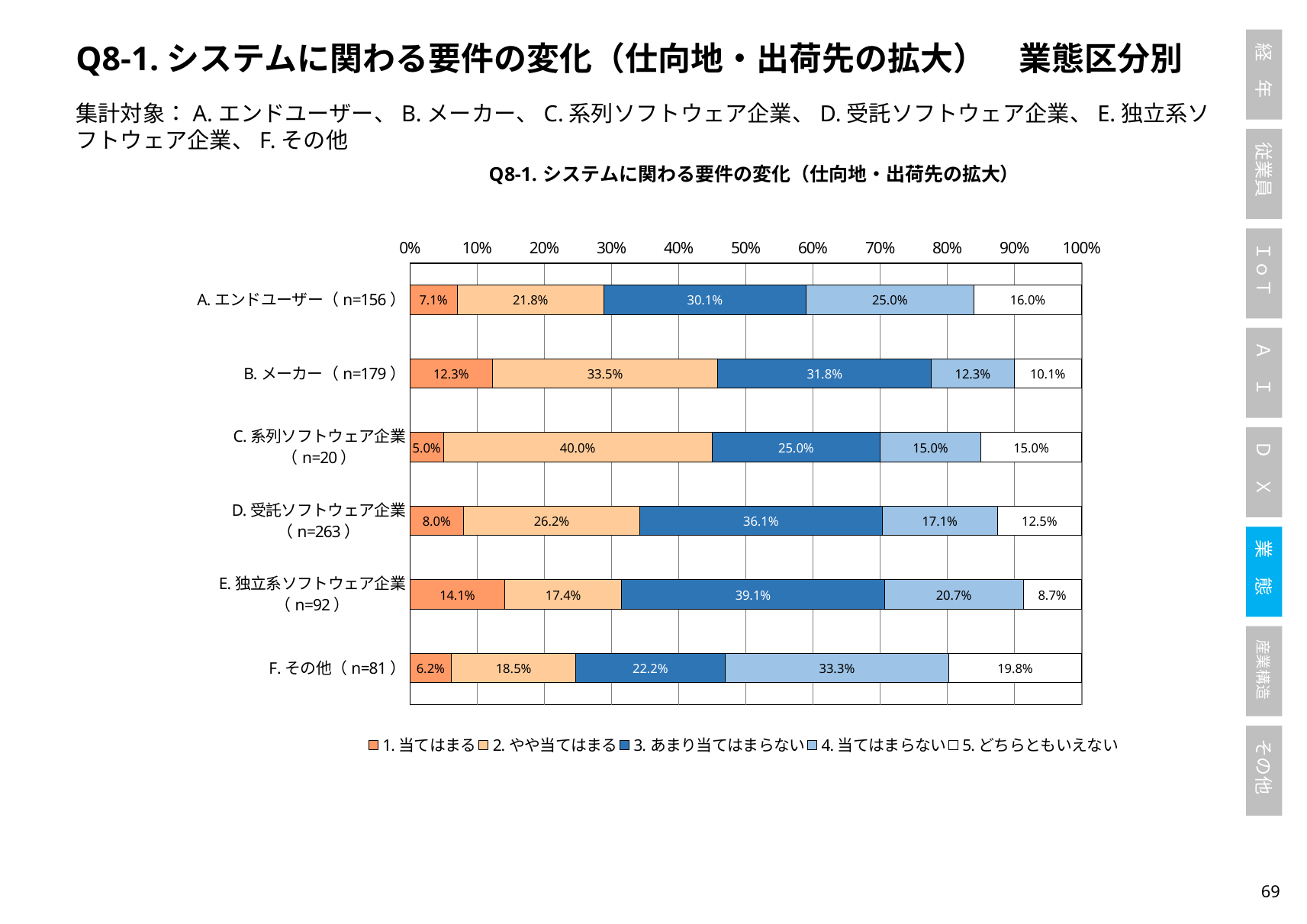
Which has the larger value for 3. あまり当てはまらない: D. 受託ソフトウェア企業 or E. 独立系ソフトウェア企業? E. 独立系ソフトウェア企業 Which category has the highest value for 2. やや当てはまる? C. 系列ソフトウェア企業 What is the first entry in the chart's legend? 1. 当てはまる In the A. エンドユーザー (n=156) bar, what is the difference between the value for 3. あまり当てはまらない and the value for 1. 当てはまる? 23.0 percentage points What is the value for 5. どちらともいえない in the D. 受託ソフトウェア企業 (n=263) bar? 12.5% What kind of chart is shown on the slide? Stacked bar chart Which category has the highest value for 1. 当てはまる? E. 独立系ソフトウェア企業 How many series does the legend list? 5 What is the value for 4. 当てはまらない in the F. その他 (n=81) bar? 33.3% Which category has the lowest value for 1. 当てはまる? C. 系列ソフトウェア企業 What is the value for 2. やや当てはまる in the B. メーカー (n=179) bar? 33.5% How many categories (bars) are shown in the chart? 6